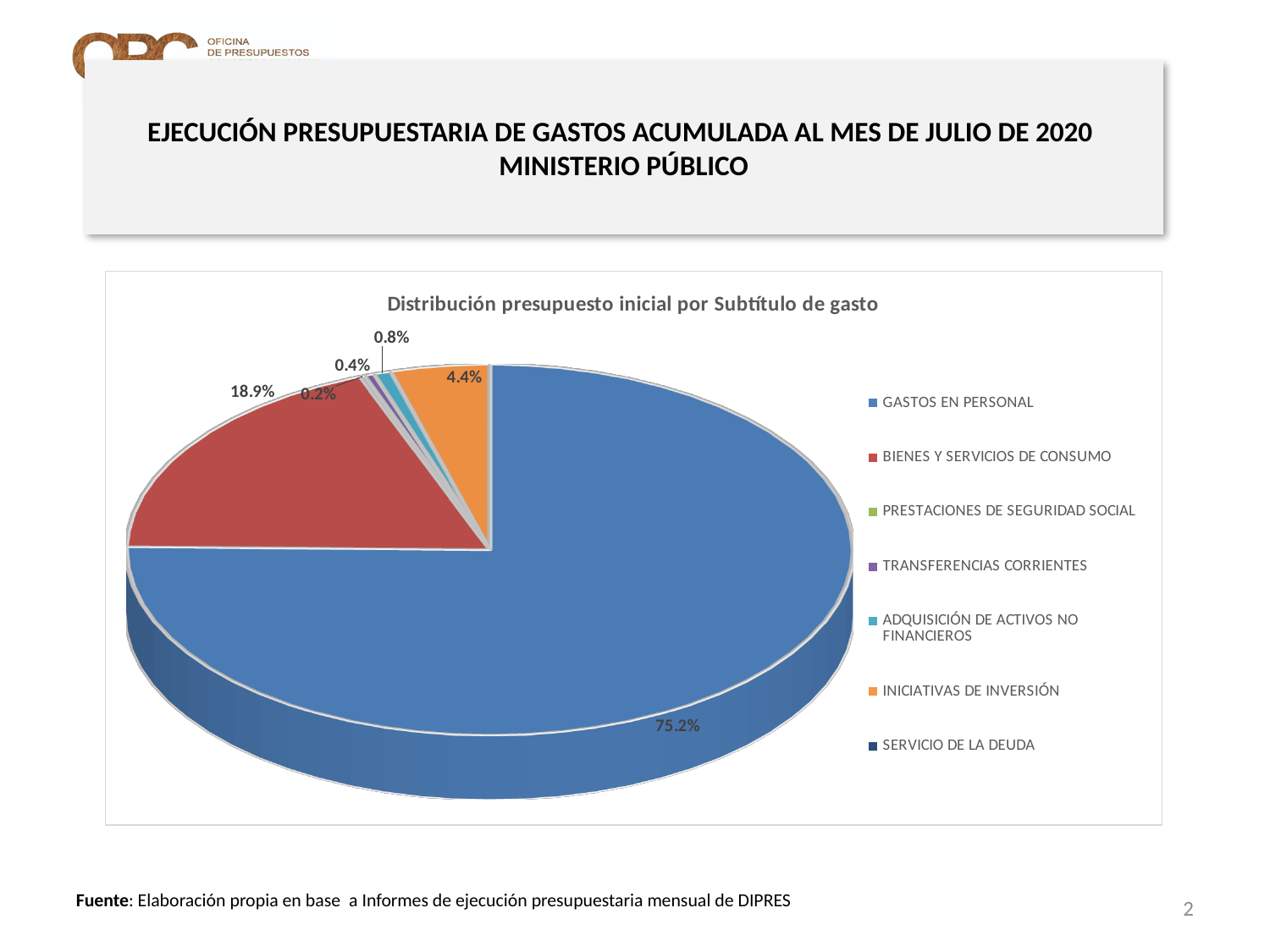
What is the title of the chart? Distribución presupuesto inicial por Subtítulo de gasto What is the difference in percentage points between GASTOS EN PERSONAL and BIENES Y SERVICIOS DE CONSUMO? 56.3 percentage points Which is larger, the share for INICIATIVAS DE INVERSIÓN or the share for ADQUISICIÓN DE ACTIVOS NO FINANCIEROS? INICIATIVAS DE INVERSIÓN What colour is the slice for BIENES Y SERVICIOS DE CONSUMO? Red What type of chart is shown on the slide? Pie chart What share of the pie does BIENES Y SERVICIOS DE CONSUMO represent? 18.9% What share of the pie does ADQUISICIÓN DE ACTIVOS NO FINANCIEROS represent? 0.8% What share of the pie does TRANSFERENCIAS CORRIENTES represent? 0.4% Which category has the largest slice of the pie? GASTOS EN PERSONAL What share of the pie does INICIATIVAS DE INVERSIÓN represent? 4.4% What share of the pie does GASTOS EN PERSONAL represent? 75.2% How many categories does the legend list? 7